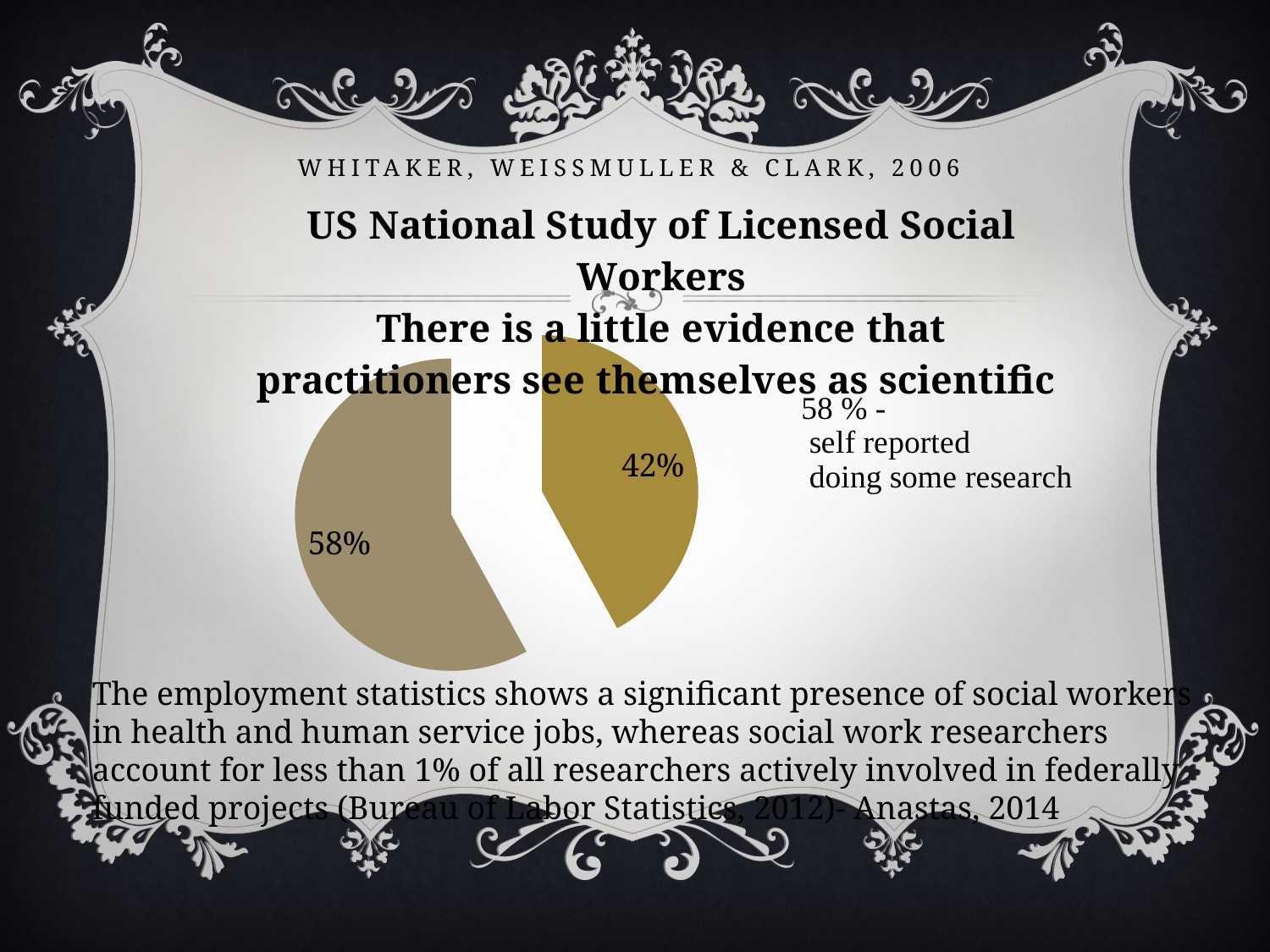
Which slice of the pie chart is shown in the darker gold colour, the 58% slice or the 42% slice? 42% What kind of chart is shown on the slide? pie chart What is the value of the smallest slice in the pie chart? 42% What is the difference between the two slices of the pie chart? 16% What share of the pie does the slice labelled 42% represent? 42% Is the larger slice of the pie chart greater or less than 50%? greater What is the value of the largest slice in the pie chart? 58% According to the text beside the pie chart, what does the 58% slice represent? self reported doing some research What do the two slices of the pie chart add up to? 100% Which slice is larger, the 58% slice or the 42% slice? 58% How many slices does the pie chart have? 2